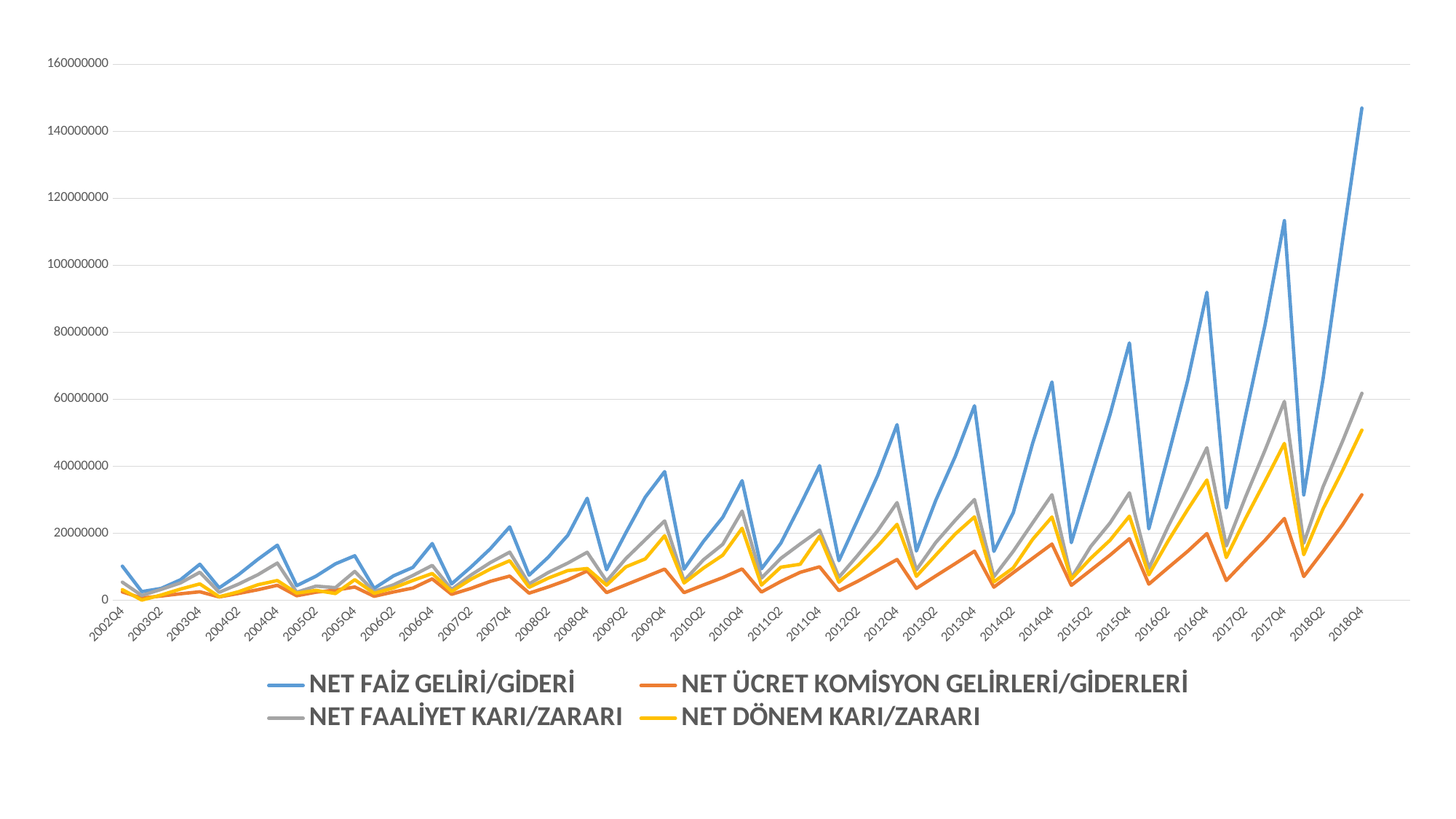
Which series has the lowest value at 2018Q4? NET ÜCRET KOMİSYON GELİRLERİ/GİDERLERİ Which series reaches the highest value on the chart? NET FAİZ GELİRİ/GİDERİ Is the value of NET ÜCRET KOMİSYON GELİRLERİ/GİDERLERİ at 2018Q4 greater or less than 40000000? less What is the highest value shown on the vertical axis? 160000000 Do the values of NET FAİZ GELİRİ/GİDERİ generally rise or fall from 2002Q4 to 2018Q4? rise Is the value of NET DÖNEM KARI/ZARARI at 2018Q4 greater or less than 40000000? greater At 2018Q4, which is larger: NET FAİZ GELİRİ/GİDERİ or NET FAALİYET KARI/ZARARI? NET FAİZ GELİRİ/GİDERİ What kind of chart is shown on the slide? line chart Is the value of NET FAİZ GELİRİ/GİDERİ at 2018Q4 greater or less than 140000000? greater How many series does the legend list? 4 What colour is the NET DÖNEM KARI/ZARARI line in the legend? yellow